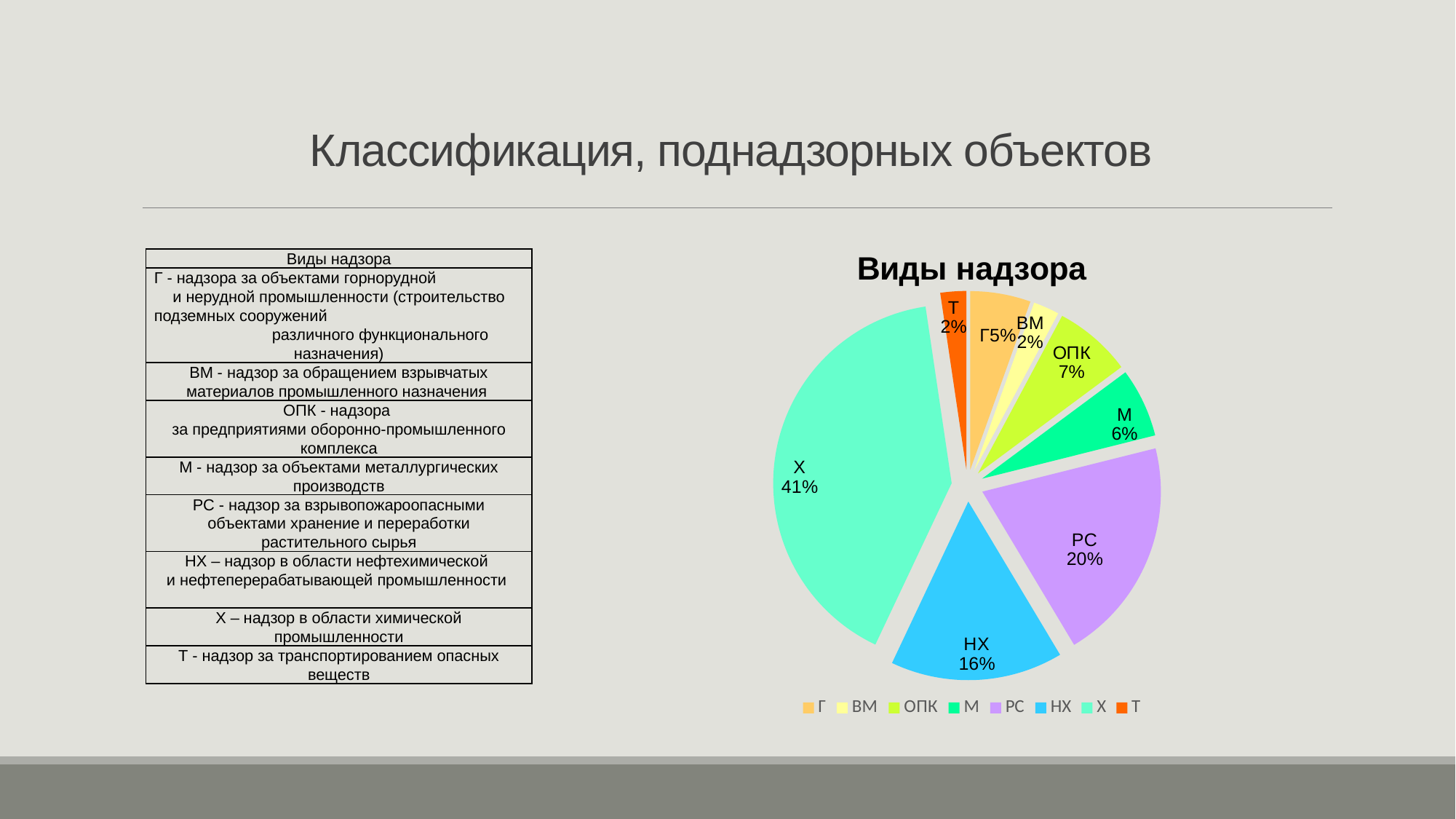
Which category has the largest slice of the pie? Х What share of the pie does the НХ slice have? 16% What kind of chart is shown on the slide? pie chart How many categories does the legend list? 8 What share of the pie does the ОПК slice have? 7% What share of the pie does the М slice have? 6% Which slice is larger, НХ or ОПК? НХ What is the combined share of the РС and НХ slices? 36% What share of the pie does the X slice have? 41% What is the chart's title? Виды надзора What share of the pie does the РС slice have? 20% What is the difference in percentage points between the Х slice and the РС slice? 21